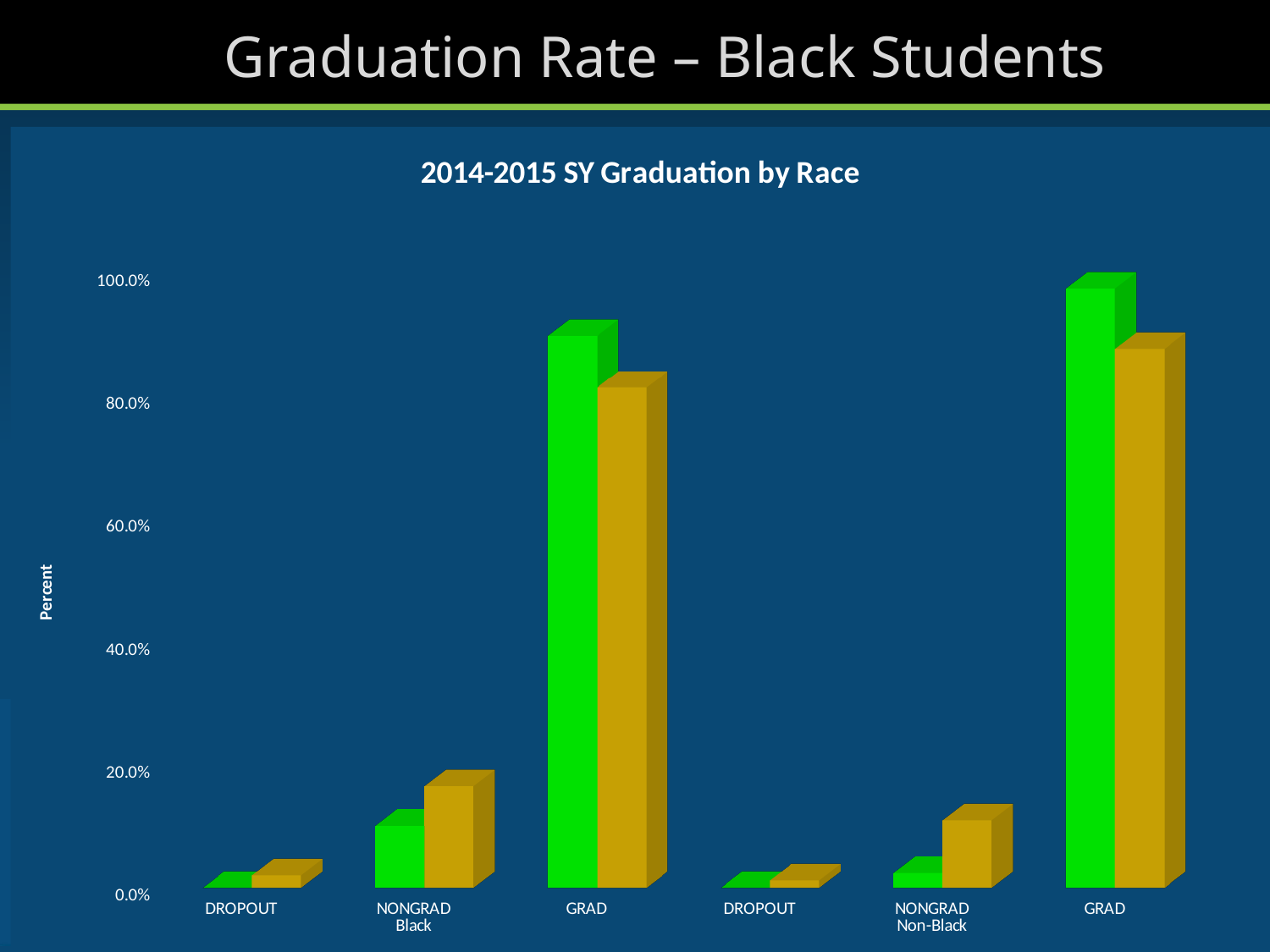
Which category has the tallest green bar in the chart? GRAD (Non-Black) Is the value of the gold bar for GRAD in the Non-Black group greater or less than 80.0%? greater Within the Black group, do the bars rise or fall going from DROPOUT to GRAD? Rise Is the value of the green bar for GRAD in the Black group greater or less than 80.0%? greater How many categories are shown along the x axis of the chart? 6 Is the value of the green bar for NONGRAD in the Non-Black group greater or less than 20.0%? less What is the title of the chart? 2014-2015 SY Graduation by Race Which group has the taller gold NONGRAD bar, Black or Non-Black? Black What kind of chart is shown on the slide? Bar chart Which group has the taller green GRAD bar, Black or Non-Black? Non-Black What is the label on the vertical axis of the chart? Percent